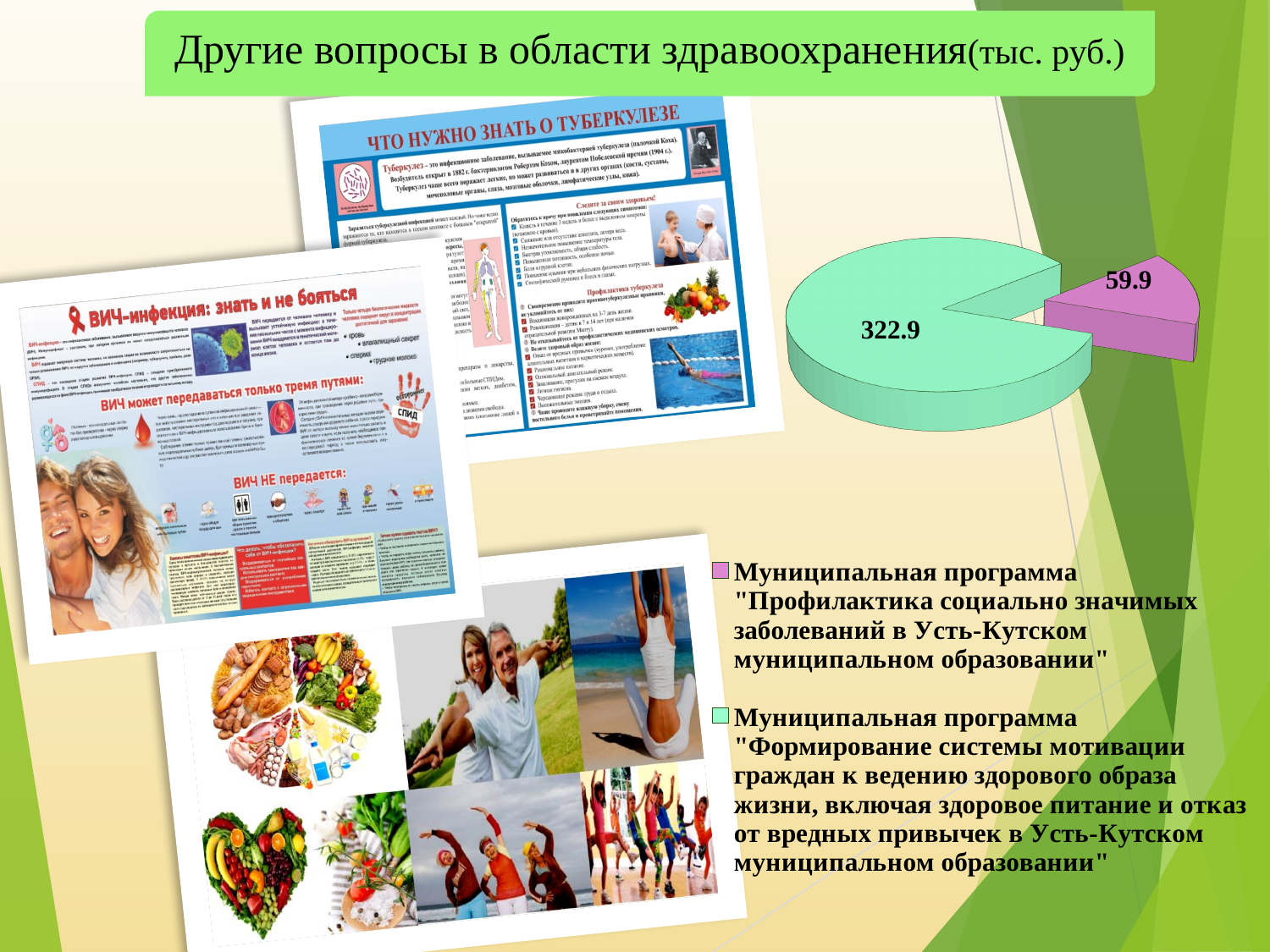
What is the total of the two values shown in the pie chart? 382.8 How many entries does the legend of the pie chart list? 2 Which programme has the larger slice in the pie chart? Муниципальная программа "Формирование системы мотивации граждан к ведению здорового образа жизни, включая здоровое питание и отказ от вредных привычек в Усть-Кутском муниципальном образовании" What is the difference between the two values shown in the pie chart? 263.0 Which programme has the smaller slice in the pie chart? Муниципальная программа "Профилактика социально значимых заболеваний в Усть-Кутском муниципальном образовании" How many slices does the pie chart have? 2 What is the value of the pink slice of the pie chart? 59.9 In what units are the values in the chart given, according to the slide title? тыс. руб. What is the value for the municipal programme "Формирование системы мотивации граждан к ведению здорового образа жизни..."? 322.9 What is the value for the municipal programme "Профилактика социально значимых заболеваний в Усть-Кутском муниципальном образовании"? 59.9 What is the value of the green slice of the pie chart? 322.9 What kind of chart is shown on the slide? Pie chart